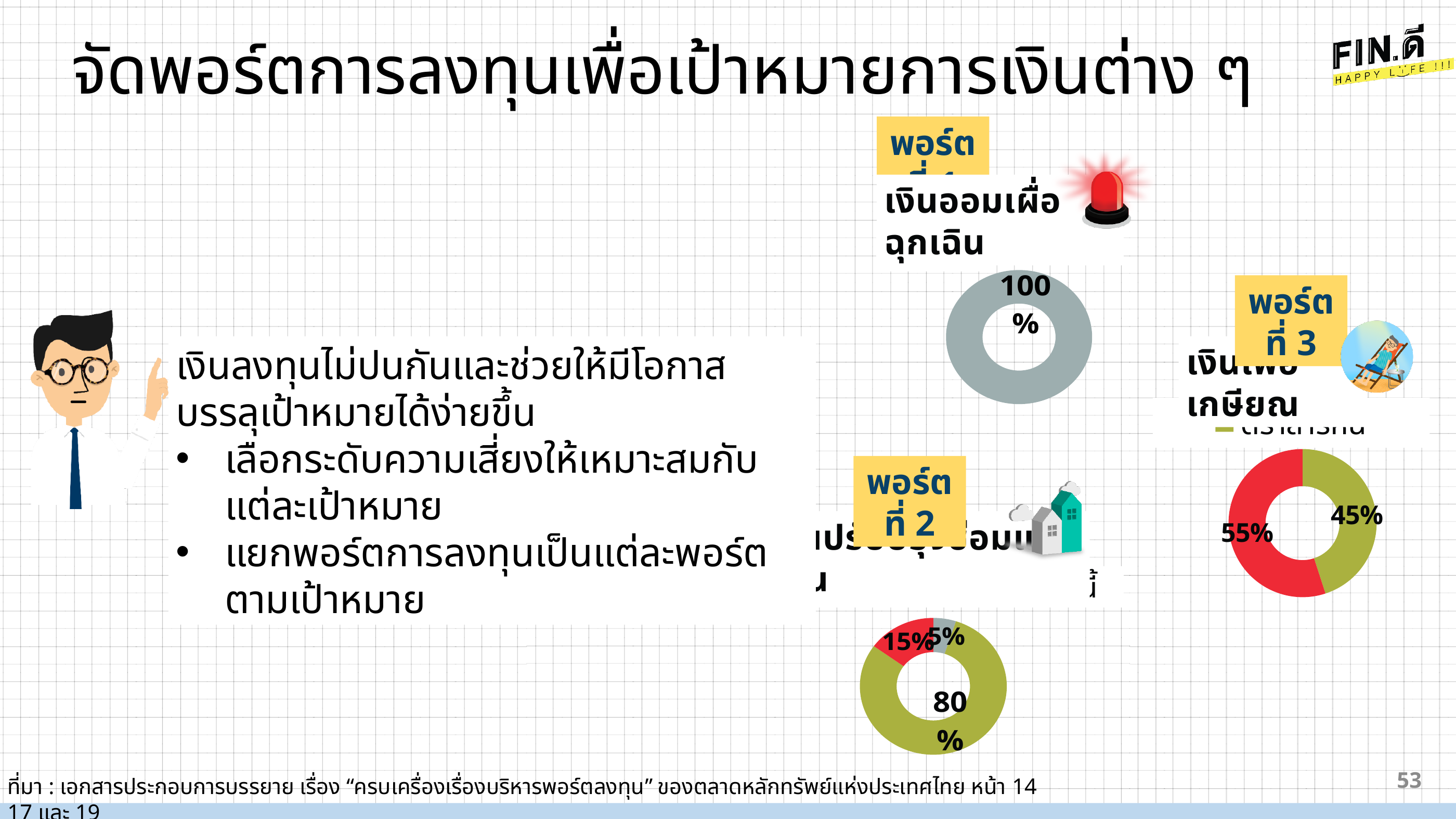
In the พอร์ตที่ 3 (เงินเพื่อเกษียณ) donut chart on the right, what percentage is shown for the red slice? 55% How many donut charts are shown on the slide? 3 In the พอร์ตที่ 2 donut chart at the bottom of the slide, what percentage is shown for the red slice? 15% In the พอร์ตที่ 1 (เงินออมเผื่อฉุกเฉิน) donut chart, what percentage is shown for the single slice? 100% In the พอร์ตที่ 2 donut chart at the bottom of the slide, what is the smallest slice's percentage? 5% How many slices does the พอร์ตที่ 1 (เงินออมเผื่อฉุกเฉิน) donut chart have? 1 What kind of chart is used for พอร์ตที่ 1 (เงินออมเผื่อฉุกเฉิน)? Donut (pie) chart In the พอร์ตที่ 3 (เงินเพื่อเกษียณ) donut chart on the right, what percentage is shown for the green slice? 45% In the พอร์ตที่ 3 (เงินเพื่อเกษียณ) donut chart on the right, which slice is larger, the red one or the green one? The red one (55%) In the พอร์ตที่ 2 donut chart at the bottom of the slide, what is the difference between the green slice (80%) and the red slice (15%)? 65% How many slices does the พอร์ตที่ 2 donut chart at the bottom of the slide have? 3 In the พอร์ตที่ 2 donut chart at the bottom of the slide, what percentage is shown for the largest (green) slice? 80%